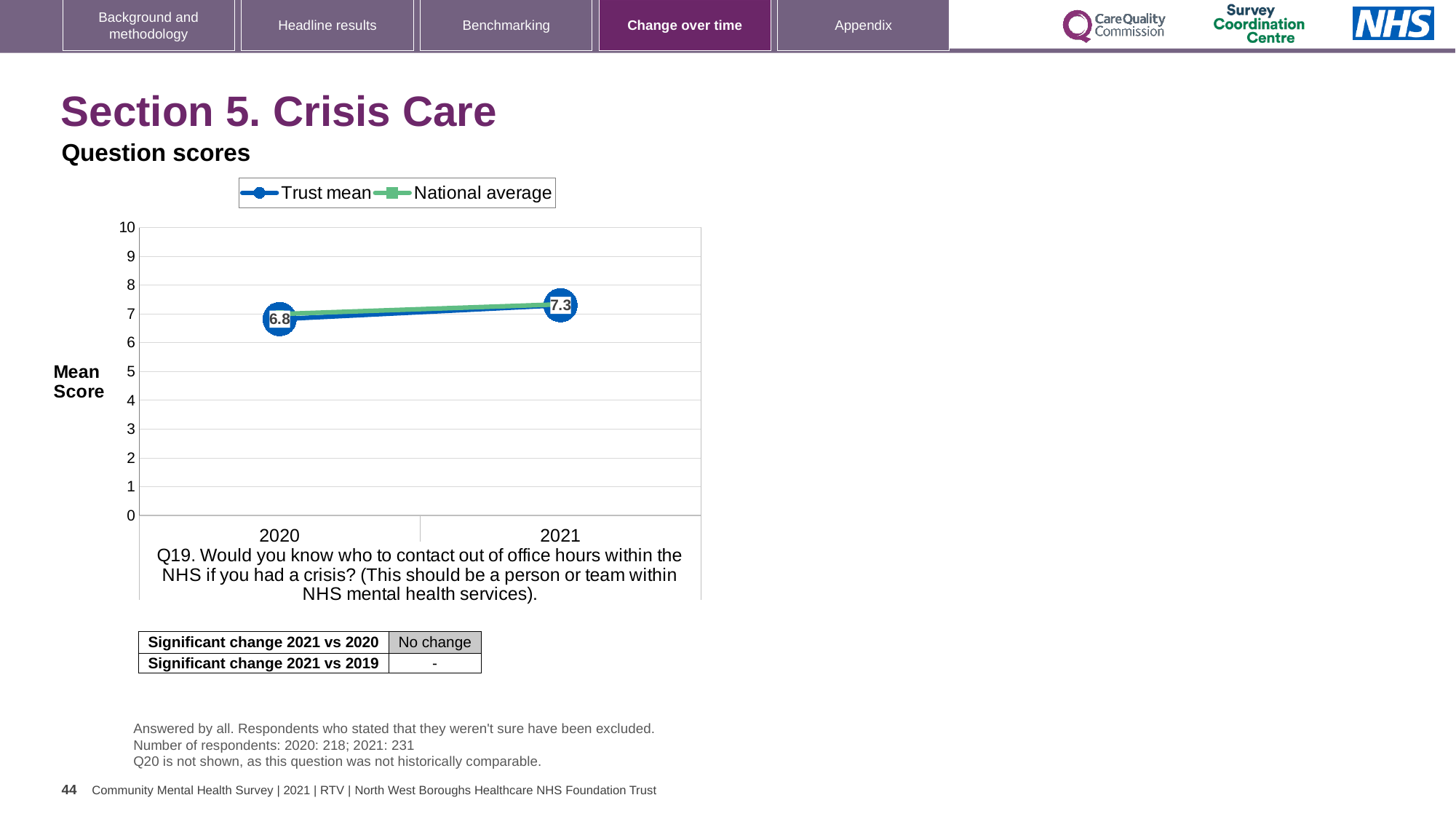
What kind of chart is shown on the slide? line chart What are the two series named in the chart legend? Trust mean and National average What is the Trust mean score for 2021? 7.3 How many years are plotted on the x axis of the chart? 2 Is the Trust mean score for 2021 greater or less than 8? less What is the Trust mean score for 2020? 6.8 What is the label on the y axis of the chart? Mean Score How many series does the chart legend list? 2 Does the Trust mean rise or fall from 2020 to 2021? rise Is the Trust mean score for 2020 greater or less than 5? greater By how much did the Trust mean score change from 2020 to 2021? 0.5 Which year has the higher Trust mean score, 2020 or 2021? 2021